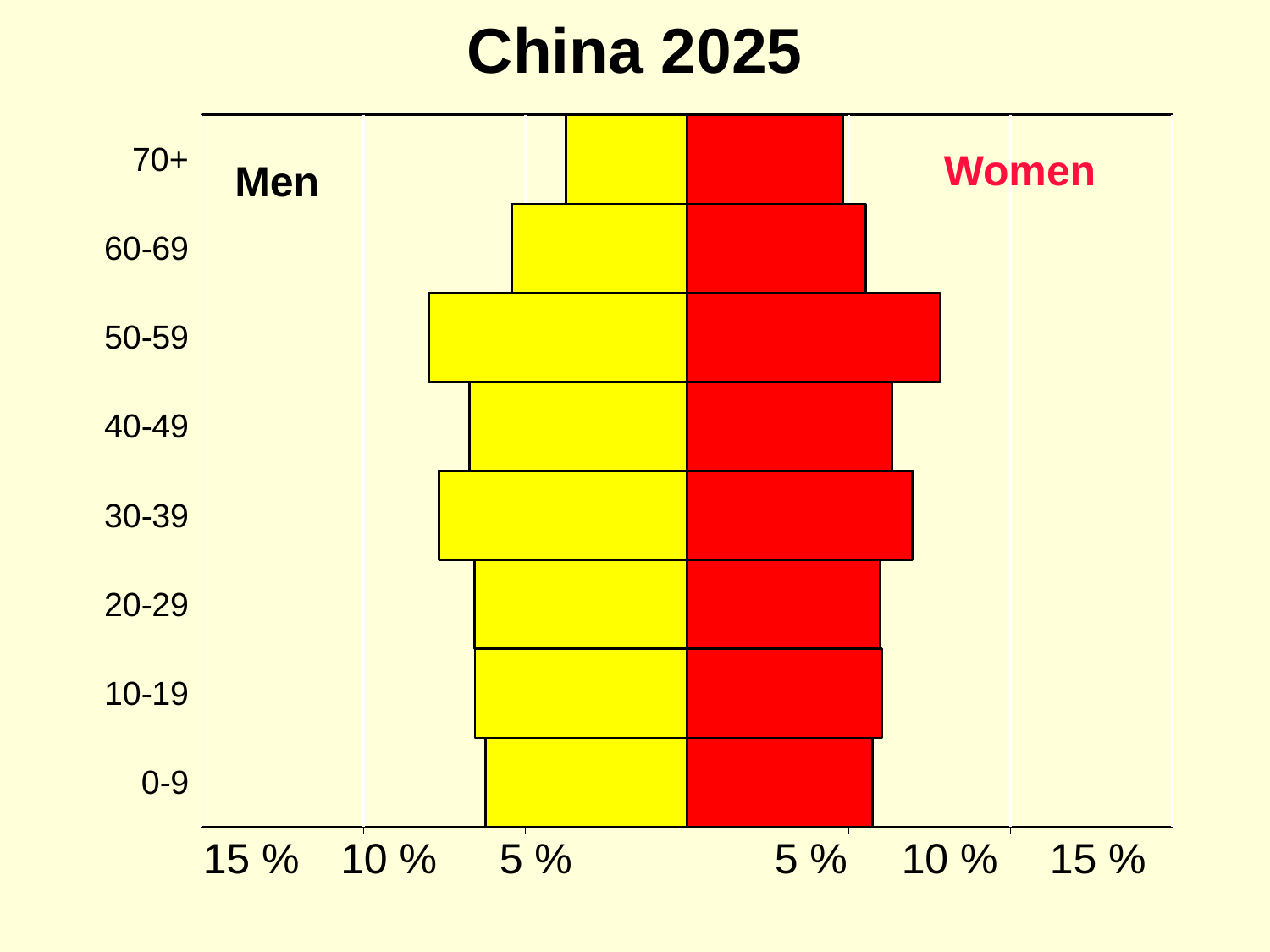
Which colour represents Women in the chart? red Which age group has the shortest bar for Women? 70+ What is the title of the chart? China 2025 Is the value for Men aged 70+ greater or less than 5 %? less How many groups (series) does the chart show? 2 For the 70+ age group, which is larger, the Men bar or the Women bar? Women How many age groups are shown on the vertical axis? 8 Which age group has the shortest bar for Men? 70+ What kind of chart is shown on the slide? bar chart (population pyramid) Is the value for Men aged 50-59 greater or less than 5 %? greater Is the value for Women aged 50-59 greater or less than 10 %? less Which age group has the longest bar for Women? 50-59